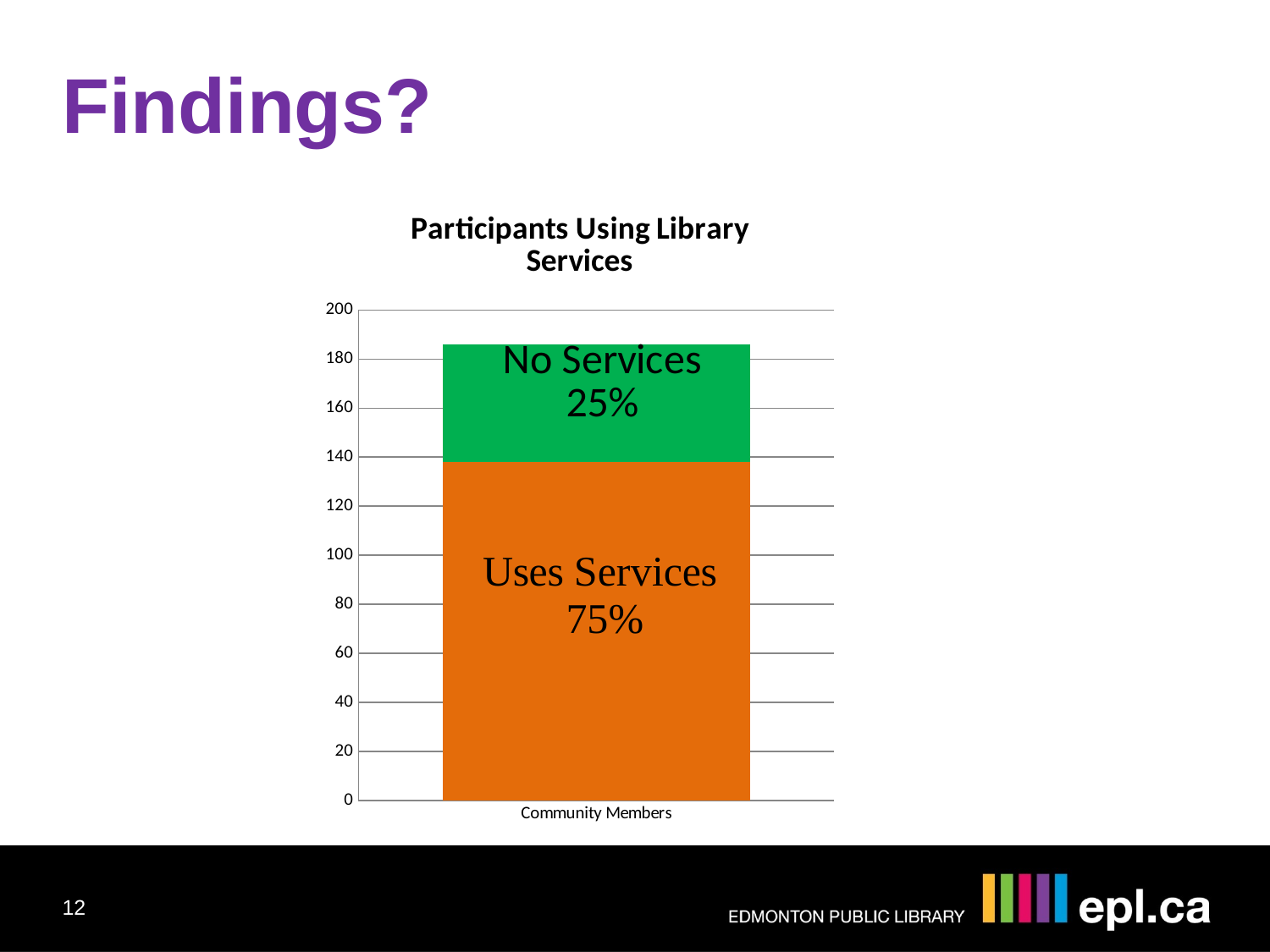
How many categories are shown on the x axis? 1 Which segment of the bar is larger, Uses Services or No Services? Uses Services Which segment has the smallest share of the bar? No Services What do the two percentage labels on the stacked bar add up to? 100% What is the title of the chart? Participants Using Library Services What percentage is shown for the Uses Services segment? 75% Is the total height of the stacked bar greater or less than 160? greater What colour is the No Services segment of the bar? green Is the top of the Uses Services segment greater or less than 120? greater What percentage is shown for the No Services segment? 25% What is the difference in percentage points between the Uses Services and No Services segments? 50 percentage points What kind of chart is shown on the slide? bar chart